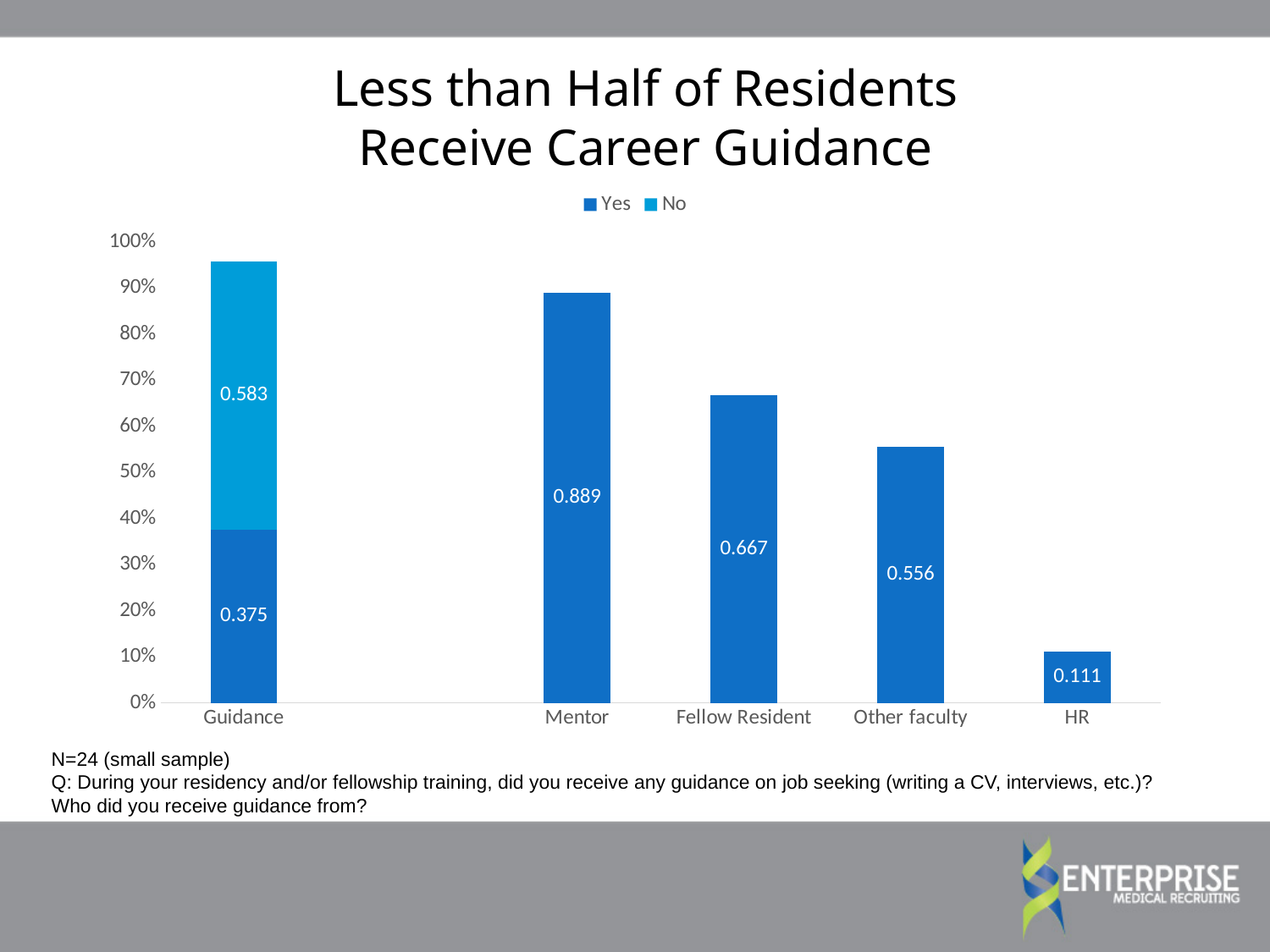
What is the value shown for HR? 0.111 How many categories are shown on the x axis? 5 What is the value shown for Mentor? 0.889 Which is larger, the value for Fellow Resident or the value for Other faculty? Fellow Resident What is the 'Yes' value for Guidance? 0.375 What is the difference between the Mentor value and the Other faculty value? 0.333 Which source of guidance has the highest value among Mentor, Fellow Resident, Other faculty and HR? Mentor What is the value shown for Fellow Resident? 0.667 How many series does the legend list? 2 Which category has the lowest value on the chart? HR What is the 'No' value for Guidance? 0.583 What is the title of the chart? Less than Half of Residents Receive Career Guidance